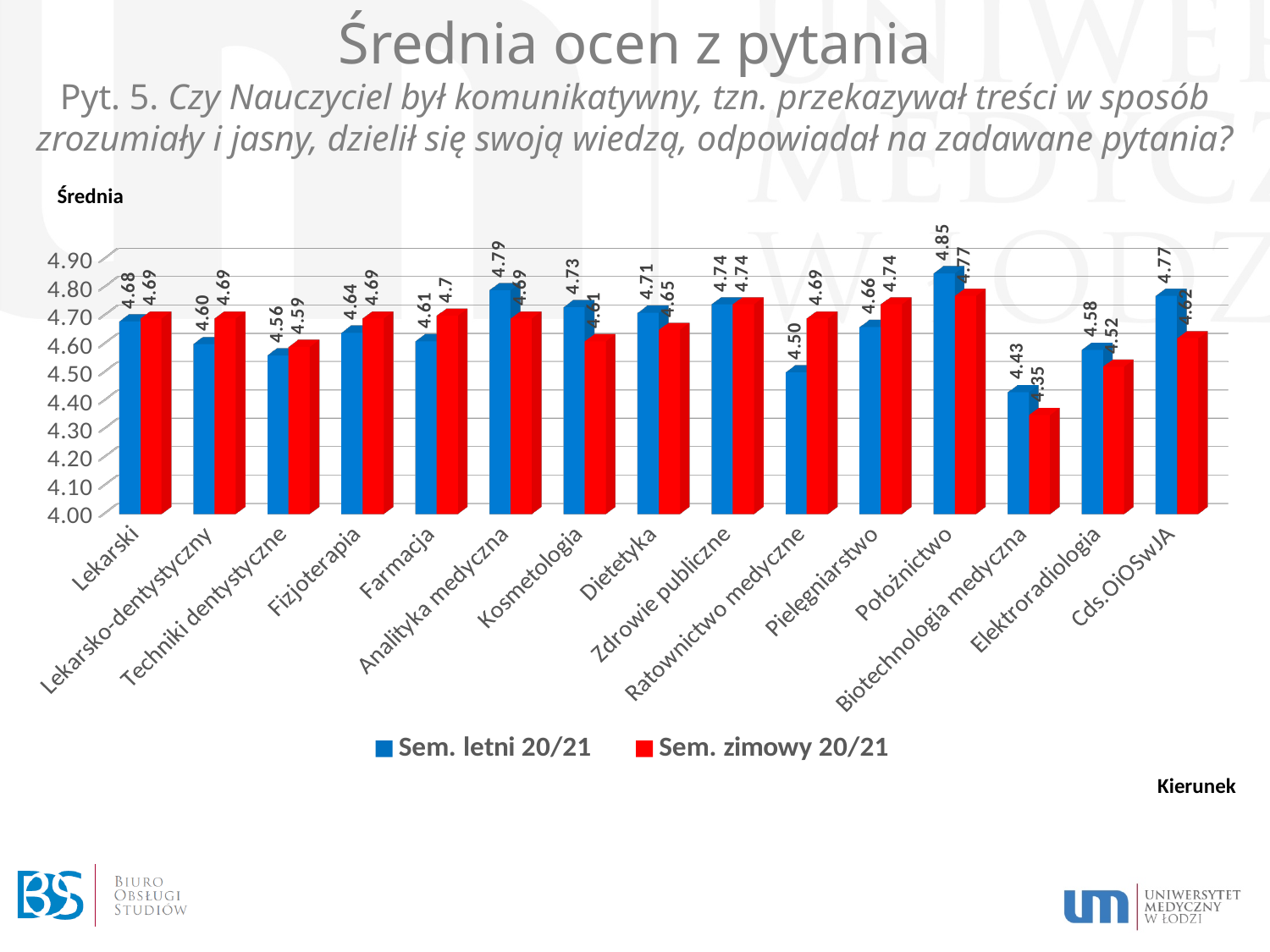
What is the difference between the Sem. zimowy 20/21 and Sem. letni 20/21 values for Ratownictwo medyczne? 0.19 What is the Sem. zimowy 20/21 value for Farmacja? 4.7 Is the Sem. zimowy 20/21 value for Biotechnologia medyczna greater or less than 4.40? less Which kierunek has the lowest Sem. letni 20/21 value? Biotechnologia medyczna What is the Sem. letni 20/21 value for Lekarski? 4.68 How many kierunki (categories) are shown on the x axis? 15 What is the Sem. letni 20/21 value for Analityka medyczna? 4.79 How many series does the legend list? 2 Which kierunek has the highest Sem. letni 20/21 value? Położnictwo What are the two series named in the legend? Sem. letni 20/21 and Sem. zimowy 20/21 What kind of chart is shown on the slide? bar chart For Techniki dentystyczne, which series has the larger value, Sem. letni 20/21 or Sem. zimowy 20/21? Sem. zimowy 20/21